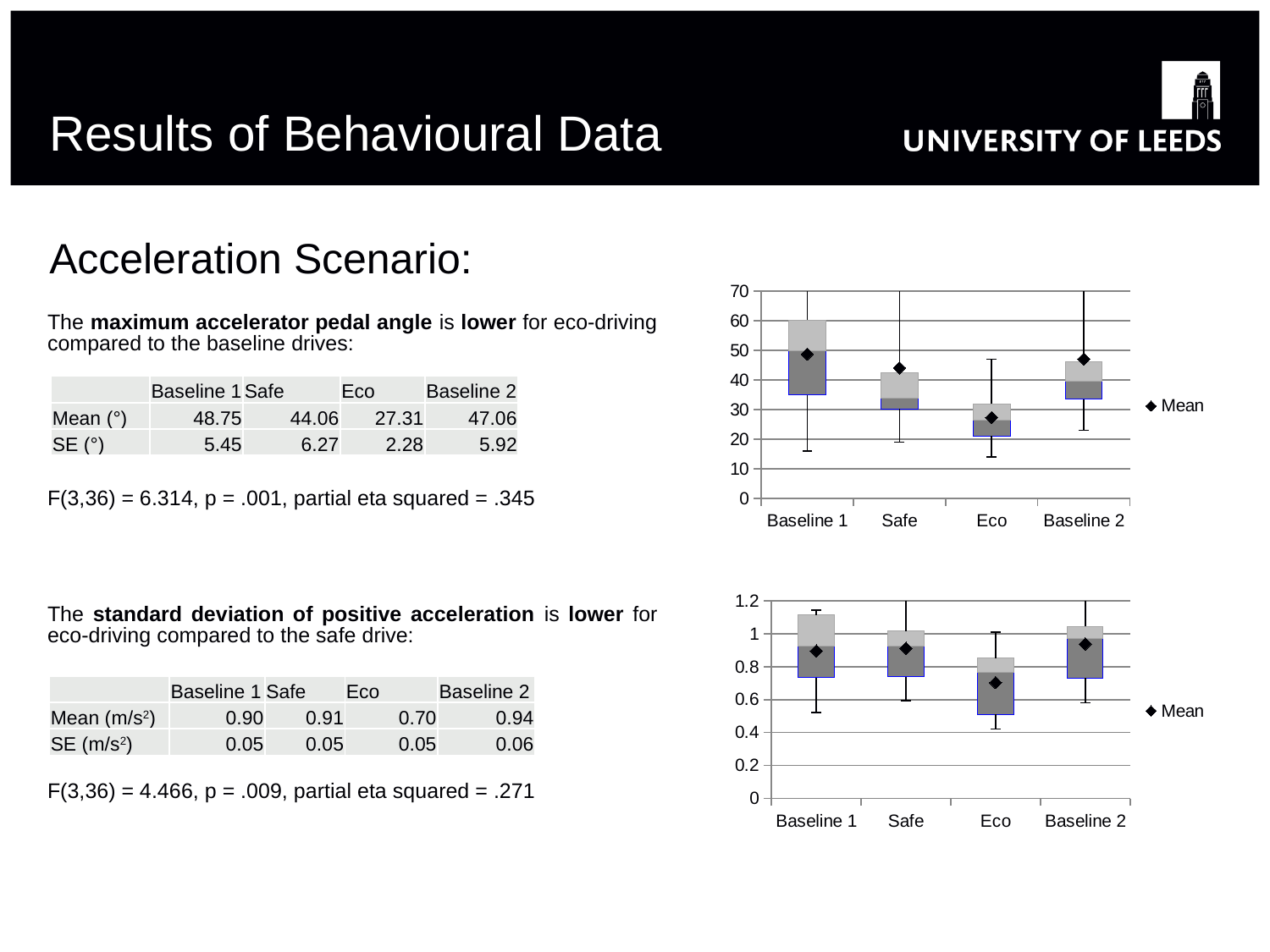
How many categories are shown on the x axis of the top chart? 4 In the bottom chart (standard deviation of positive acceleration), which category has the lowest mean marker? Eco In the bottom chart, is the mean value for Eco greater or less than 0.8? less In the top chart, is the mean value for Eco greater or less than 30? less How many series does the legend of the bottom chart list? 1 What is the single legend entry shown next to the top chart? Mean In the bottom chart, which has the larger mean, Baseline 2 or Eco? Baseline 2 In the top chart, which has the larger mean, Safe or Eco? Safe In the top chart, is the mean value for Baseline 1 greater or less than 40? greater What is the mean accelerator pedal angle for Eco shown in the top chart (as given in the table)? 27.31 In the top chart (accelerator pedal angle), which category has the lowest mean marker? Eco